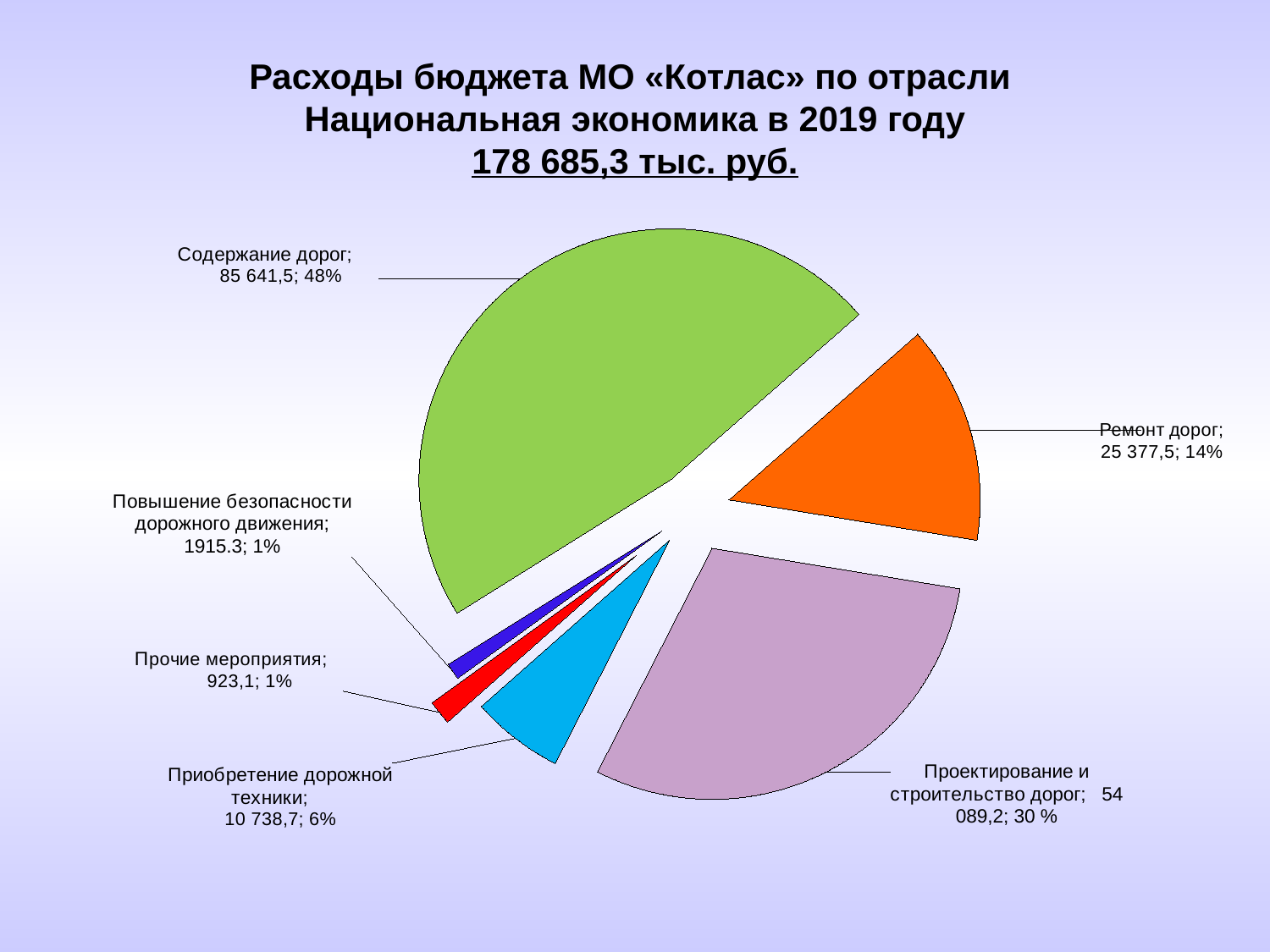
Which category has the largest slice of the pie? Содержание дорог What is the value for Прочие мероприятия? 923,1 What kind of chart is shown on the slide? pie chart What is the value for Проектирование и строительство дорог? 54 089,2 Which is larger, Ремонт дорог or Проектирование и строительство дорог? Проектирование и строительство дорог How many slices does the pie chart have? 6 What is the value for Содержание дорог? 85 641,5 What share of the pie does Приобретение дорожной техники represent? 6% What is the difference between the values for Содержание дорог and Ремонт дорог? 60 264,0 What share of the pie does Ремонт дорог represent? 14% What total amount is stated in the chart title? 178 685,3 тыс. руб.